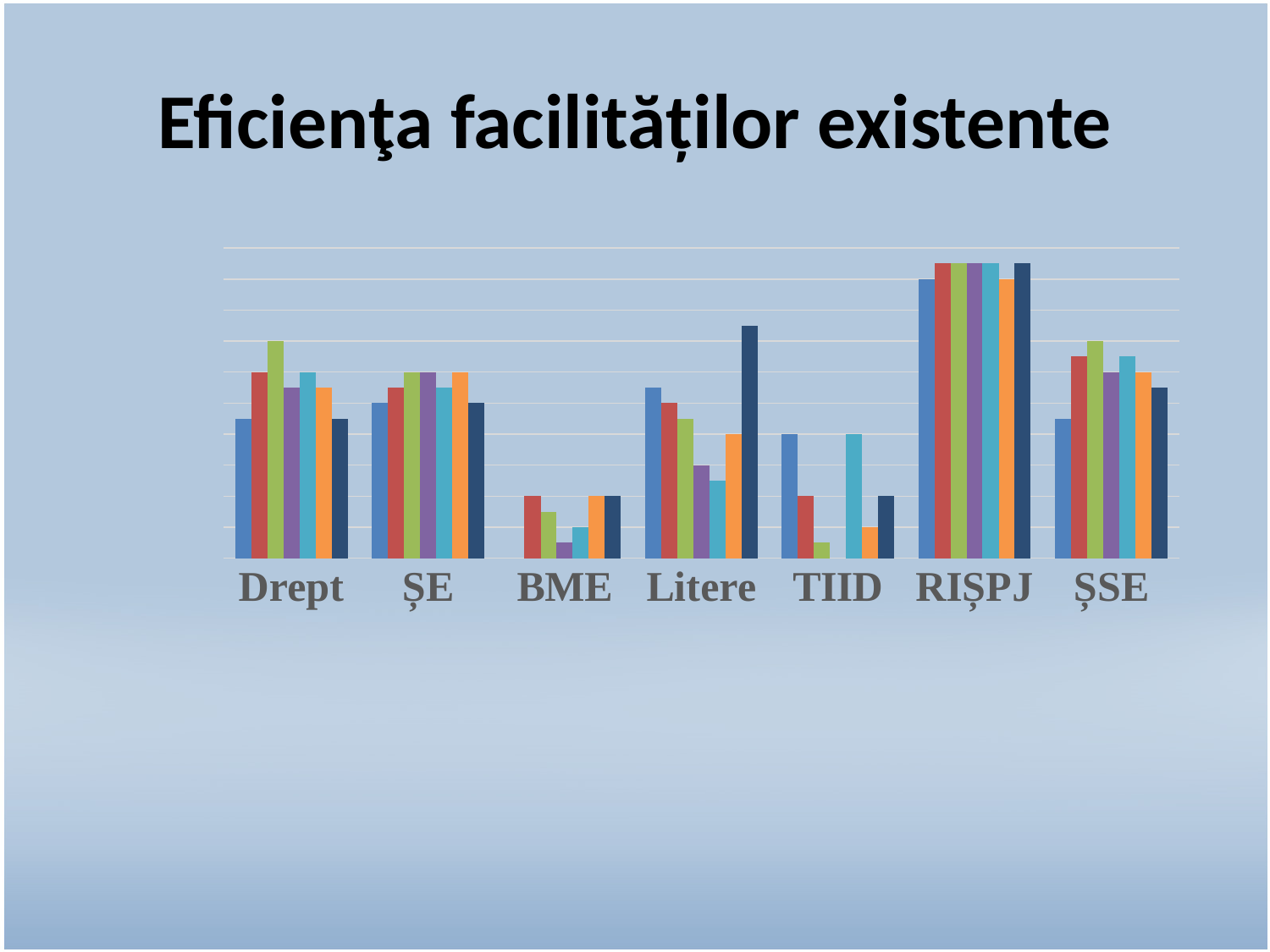
Which category has the lowest value for the green (third) bar? TIID What kind of chart is shown on the slide? bar chart For the dark blue (last) bar, which is larger: Litere or Drept? Litere What is the first category label on the x axis of the chart? Drept Which category has the tallest bars overall in the chart? RIȘPJ For the green (third) bar, which is larger: Litere or TIID? Litere Which category has the highest value for the cyan (fifth) bar? RIȘPJ For the orange (sixth) bar, which is larger: RIȘPJ or ȘSE? RIȘPJ What is the title of the slide containing the chart? Eficienţa facilităților existente How many categories are shown on the x axis of the chart? 7